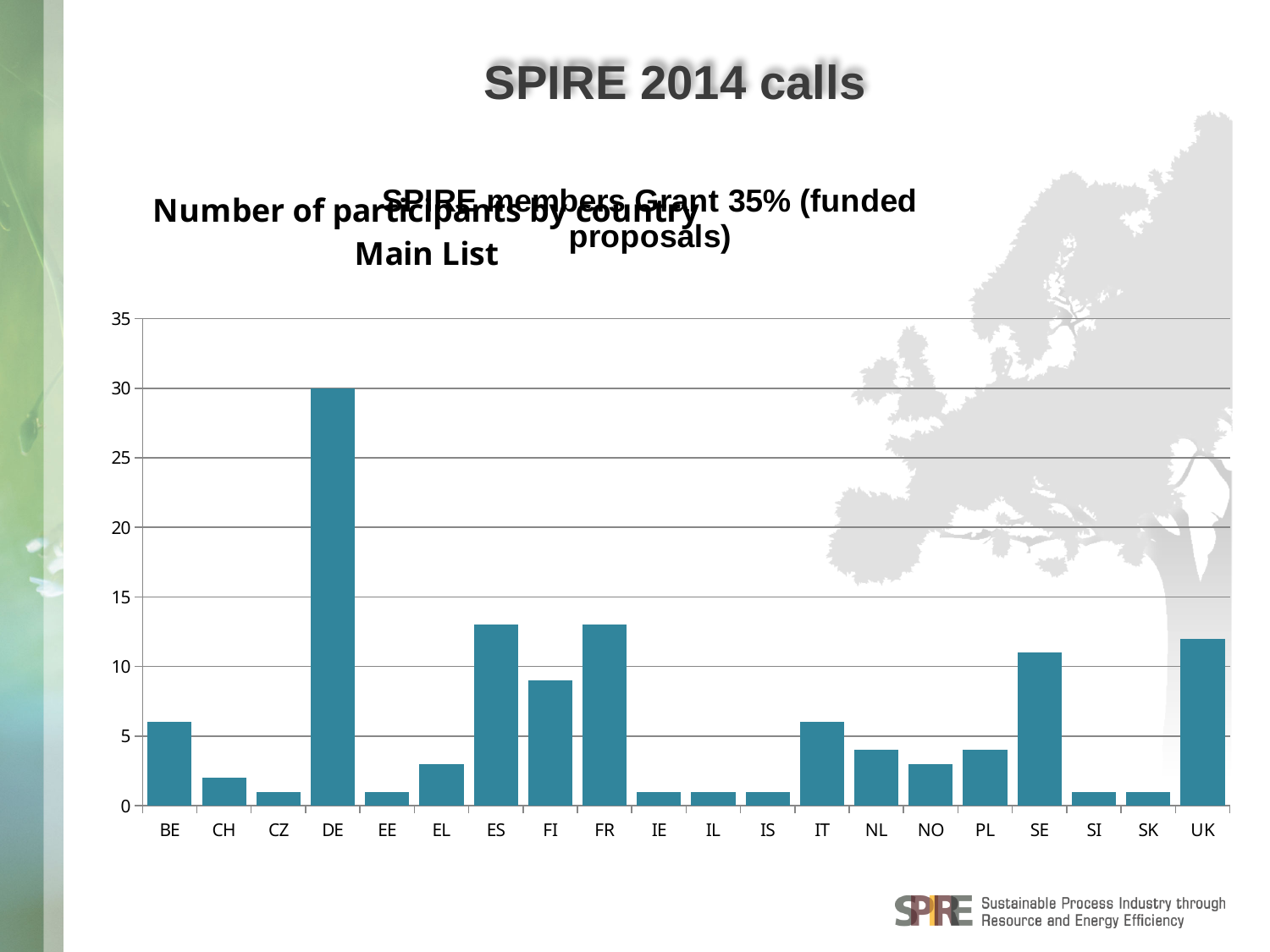
What is the title of the slide? SPIRE 2014 calls Is the value for ES greater or less than 15? less What is the value for DE? 30 Which is larger, the value for ES or the value for FI? ES Is the value for FI greater or less than 10? less Is the value for UK greater or less than 10? greater How many countries are shown on the x axis of the chart? 20 Which country has the highest number of participants? DE What type of chart is shown on the slide? bar chart Which is larger, the value for BE or the value for CH? BE